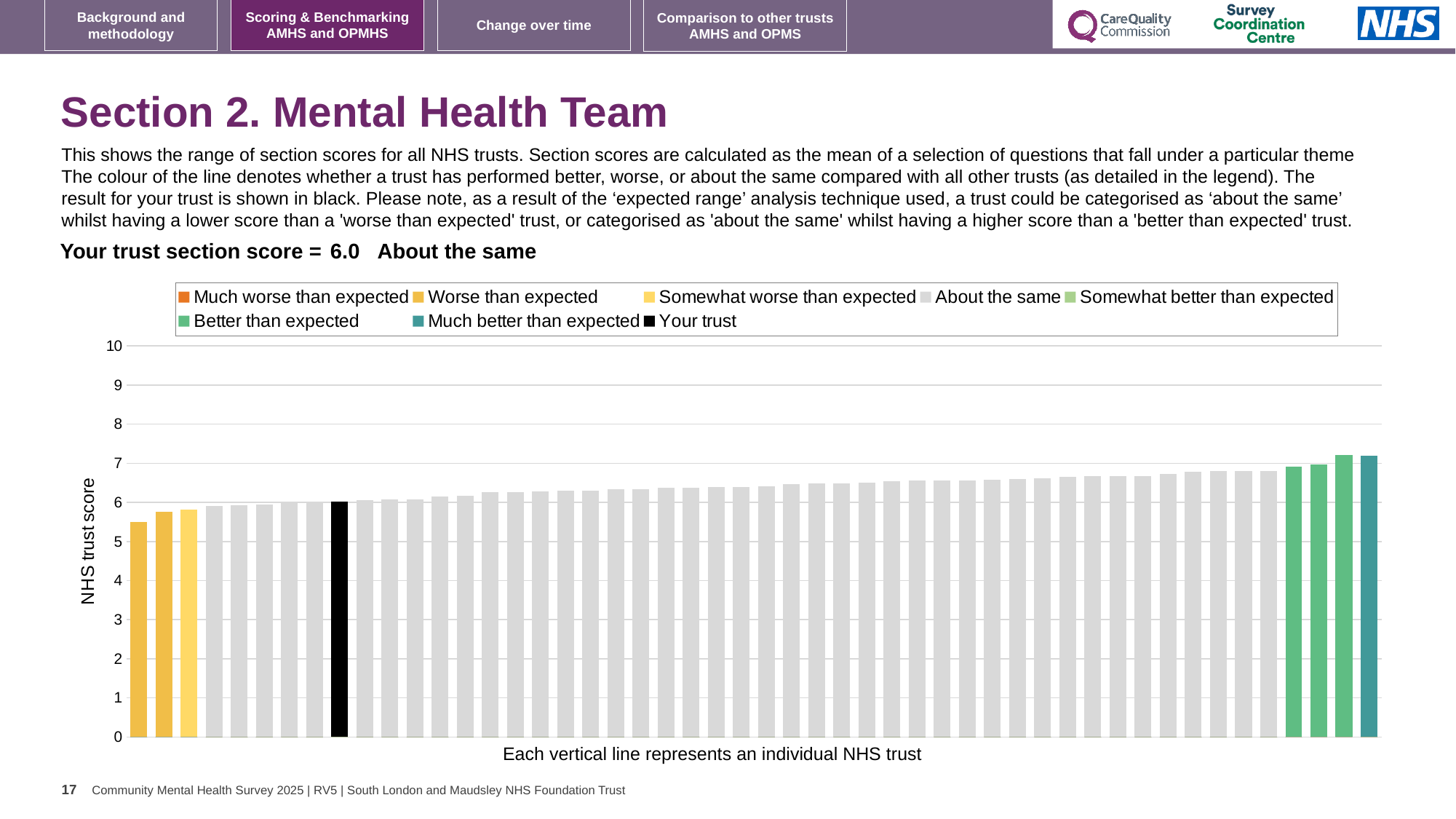
Which legend category do the tallest bars on the chart belong to? Better than expected What kind of chart is shown on the slide? bar chart Is the value of the black 'Your trust' bar greater or less than 5? greater What colour is the bar representing your trust? black What is the section score for your trust shown on the slide? 6.0 How many bars are coloured as 'Worse than expected' (yellow)? 2 Is the value of the leftmost (lowest) bar greater or less than 6? less Is the value of the rightmost bar greater or less than 6? greater How many entries does the chart legend list? 8 Do the bar values rise or fall from left to right along the x axis? rise How many bars are coloured as 'Much better than expected' (teal)? 1 What is the label on the y axis of the chart? NHS trust score